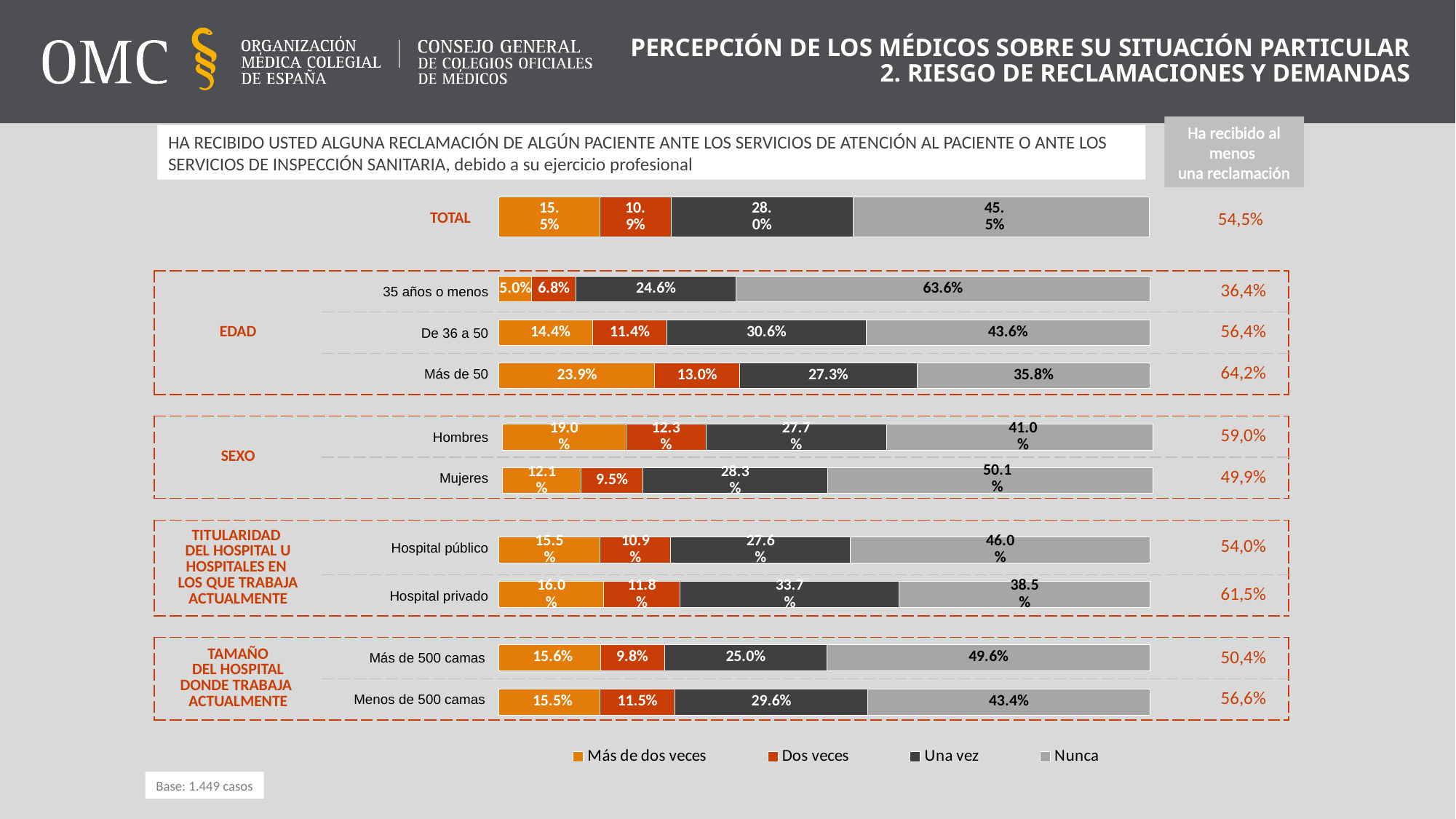
What percentage of 'Hospital privado' respondents have received at least one complaint ('Ha recibido al menos una reclamación')? 61,5% Which age group (EDAD) has the highest 'Nunca' value? 35 años o menos What is the 'Más de dos veces' value for 'Más de 50'? 23.9% Which has a larger 'Una vez' value: 'Más de 500 camas' or 'Menos de 500 camas'? Menos de 500 camas What is the difference between the 'Nunca' values for 'Mujeres' and 'Hombres'? 9.1% What kind of chart is shown on the slide? Stacked bar chart What is the 'Dos veces' value for 'Mujeres'? 9.5% How many series does the legend list? 4 What is the 'Una vez' value for 'Hospital privado'? 33.7% Which age group (EDAD) has the lowest 'Más de dos veces' value? 35 años o menos Which legend entry is shown in dark grey? Una vez What is the 'Nunca' value for the TOTAL bar? 45.5%